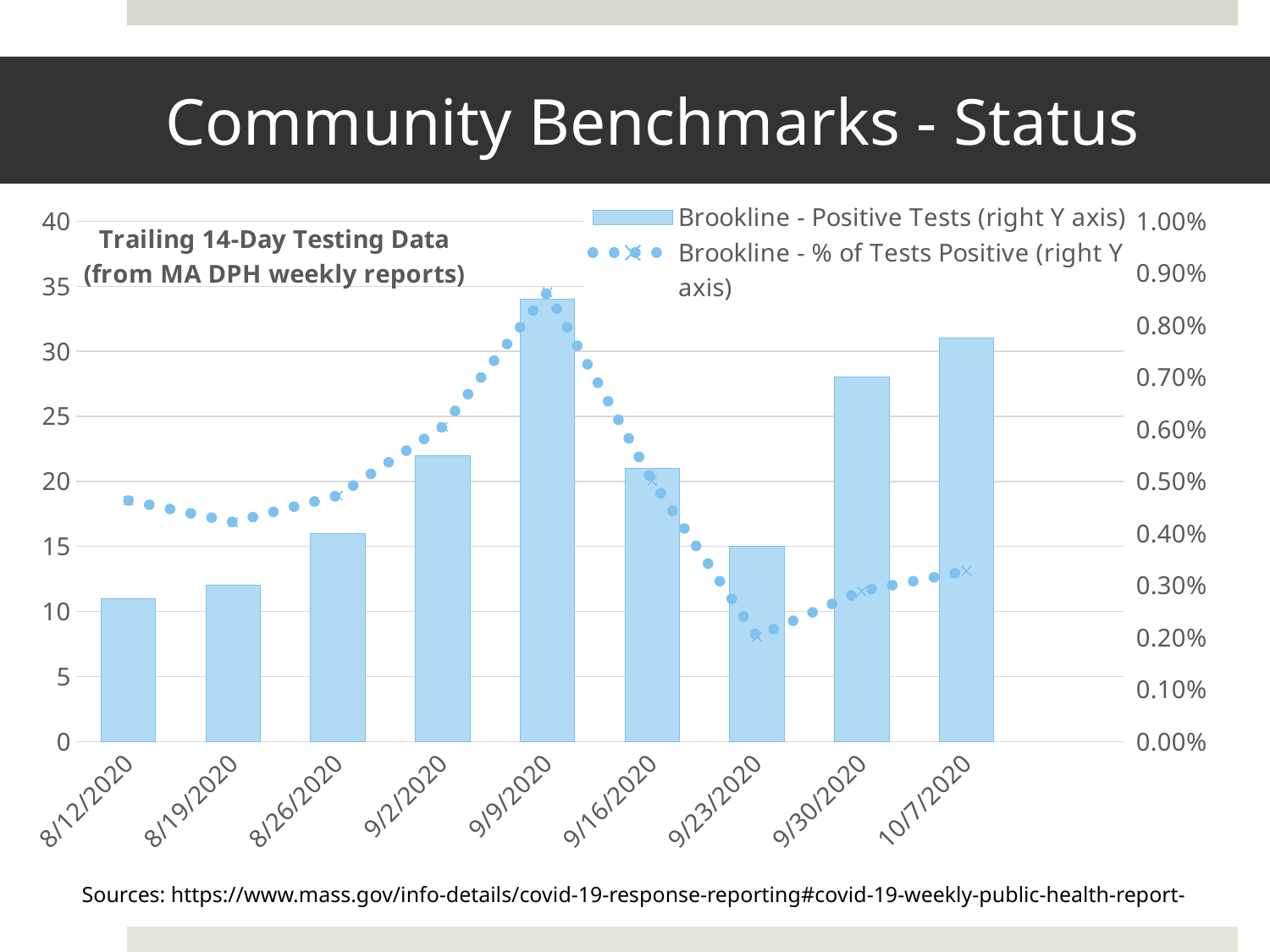
What kind of chart is shown on the slide? Combination bar and line chart What is the text in the box at the top left of the chart? Trailing 14-Day Testing Data (from MA DPH weekly reports) On which date is the Brookline - Positive Tests bar the highest? 9/9/2020 Do the Brookline - Positive Tests bars rise or fall from 9/23/2020 to 10/7/2020? Rise How many series does the legend list? 2 Is the Brookline - Positive Tests value for 9/23/2020 greater or less than 20? less On which date is the Brookline - % of Tests Positive line at its lowest? 9/23/2020 Which date has the larger Brookline - Positive Tests bar, 9/16/2020 or 9/30/2020? 9/30/2020 On which date does the Brookline - % of Tests Positive line reach its peak? 9/9/2020 How many dates are shown on the x axis? 9 Is the Brookline - % of Tests Positive value for 9/23/2020 greater or less than 0.30%? less Is the Brookline - Positive Tests value for 9/9/2020 greater or less than 30? greater